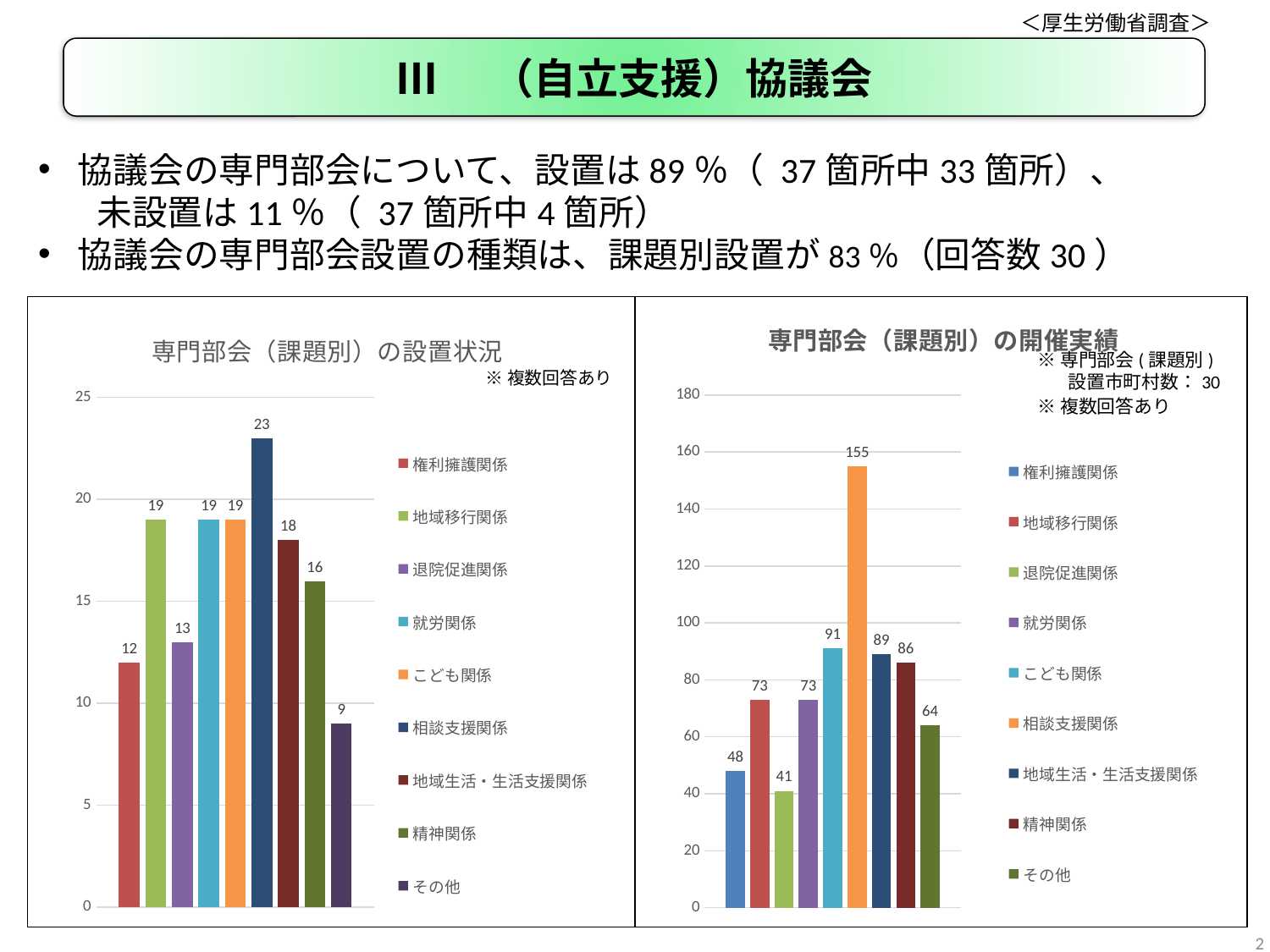
In the chart titled 専門部会（課題別）の開催実績, which category has the lowest value? 退院促進関係 In the chart titled 専門部会（課題別）の開催実績, which category has the highest value? 相談支援関係 In the chart titled 専門部会（課題別）の開催実績, what is the difference between こども関係 and 権利擁護関係? 43 In the chart titled 専門部会（課題別）の設置状況, what is the value for 相談支援関係? 23 What kind of chart is 専門部会（課題別）の開催実績? bar chart In the chart titled 専門部会（課題別）の開催実績, what is the value for 相談支援関係? 155 In the chart titled 専門部会（課題別）の設置状況, what is the difference between 相談支援関係 and 権利擁護関係? 11 In the chart titled 専門部会（課題別）の開催実績, what is the value for その他? 64 In the chart titled 専門部会（課題別）の設置状況, how many categories are plotted? 9 In the chart titled 専門部会（課題別）の設置状況, which category has the lowest value? その他 In the chart titled 専門部会（課題別）の設置状況, which is larger, 退院促進関係 or 精神関係? 精神関係 In the chart titled 専門部会（課題別）の開催実績, how many entries does the legend list? 9